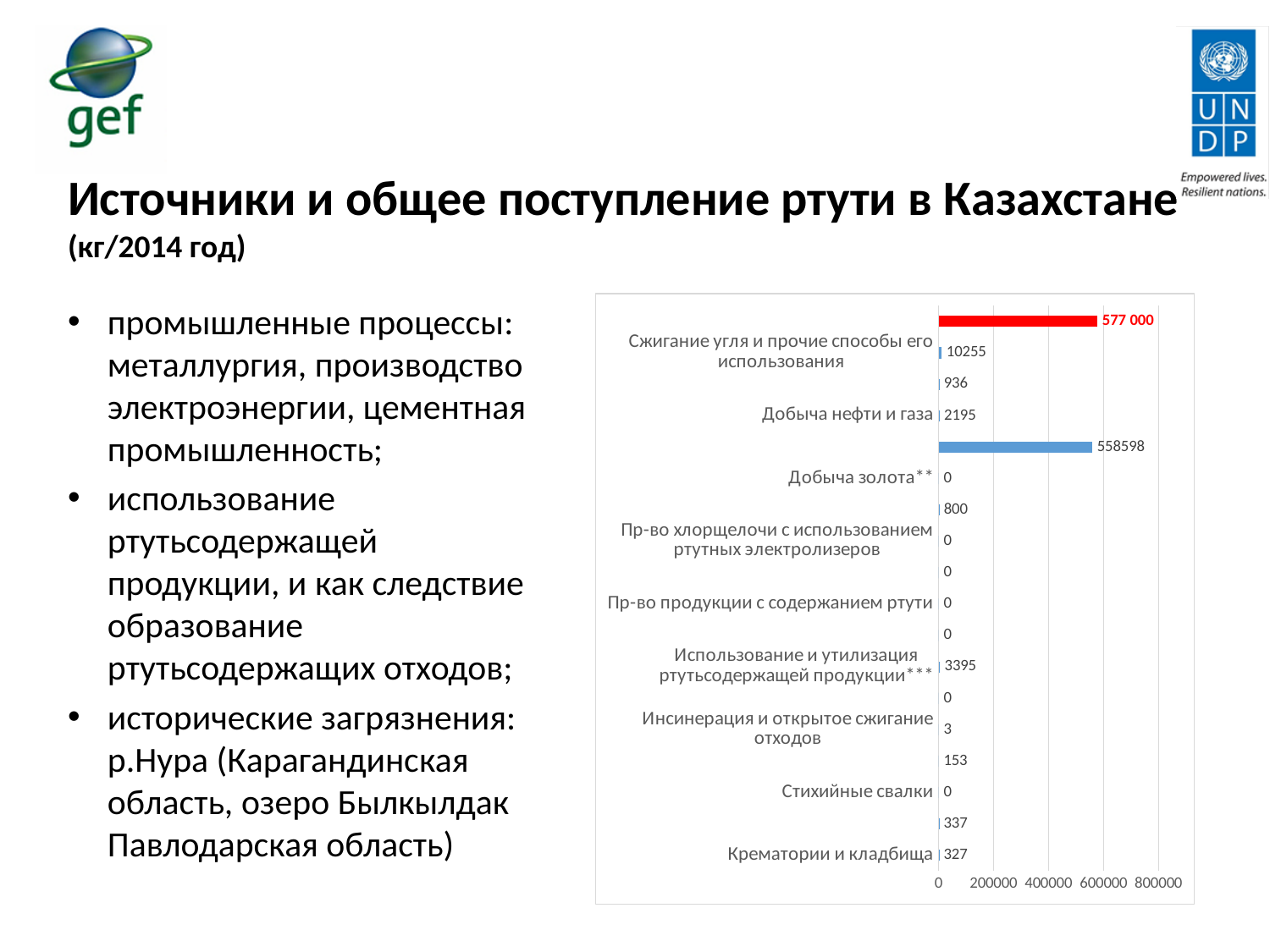
What value is labelled on the longest blue bar in the chart? 558598 What is the difference between the red bar value (577 000) and the longest blue bar value (558598)? 18402 What is the value for Добыча нефти и газа? 2195 What is the highest tick value shown on the horizontal axis of the chart? 800000 Is the value of the red bar greater or less than 400000? greater Which is larger, the red bar (577 000) or the longest blue bar (558598)? 577 000 What value is labelled on the red bar in the chart? 577 000 What kind of chart is shown on the slide? bar chart What is the largest value shown in the chart? 577 000 How many category labels are printed on the vertical axis of the chart? 9 What is the value for Стихийные свалки? 0 What is the value for Крематории и кладбища? 327